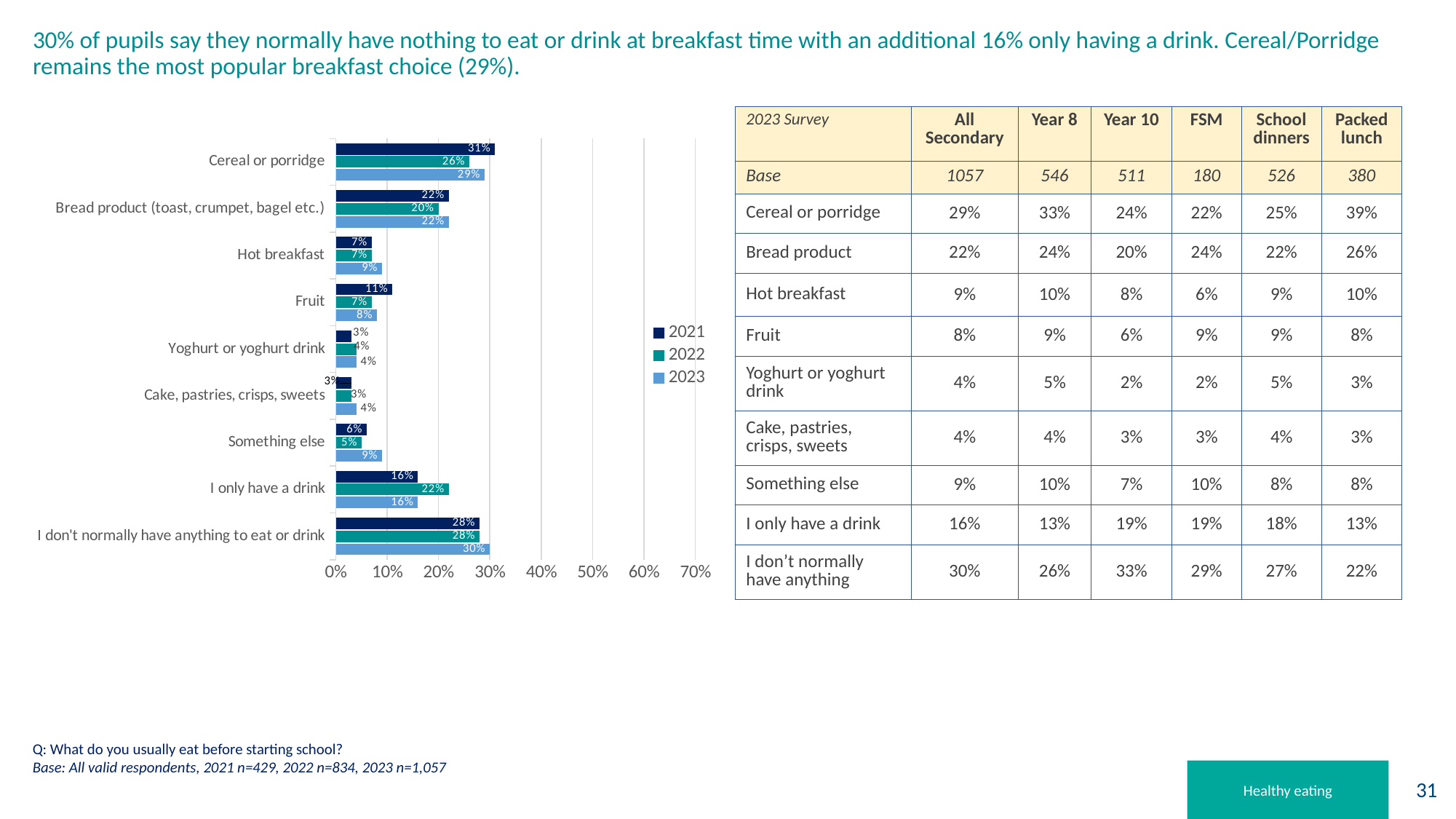
Is the 2023 value for 'I don't normally have anything to eat or drink' greater or less than 20%? greater Which is larger in the chart: the 2023 value for 'Something else' or the 2023 value for 'Fruit'? Something else How many categories are plotted on the chart? 9 What is the 2023 value for 'Cereal or porridge' in the chart? 29% How many series does the chart legend list? 3 Which category has the highest 2023 value in the chart? I don't normally have anything to eat or drink What is the difference between the 2021 and 2022 values for 'Cereal or porridge' in the chart? 5% What is the 2022 value for 'I only have a drink' in the chart? 22% Which year does the lightest blue series in the chart legend represent? 2023 What kind of chart is shown on the slide? bar chart What is the 2021 value for 'Fruit' in the chart? 11%